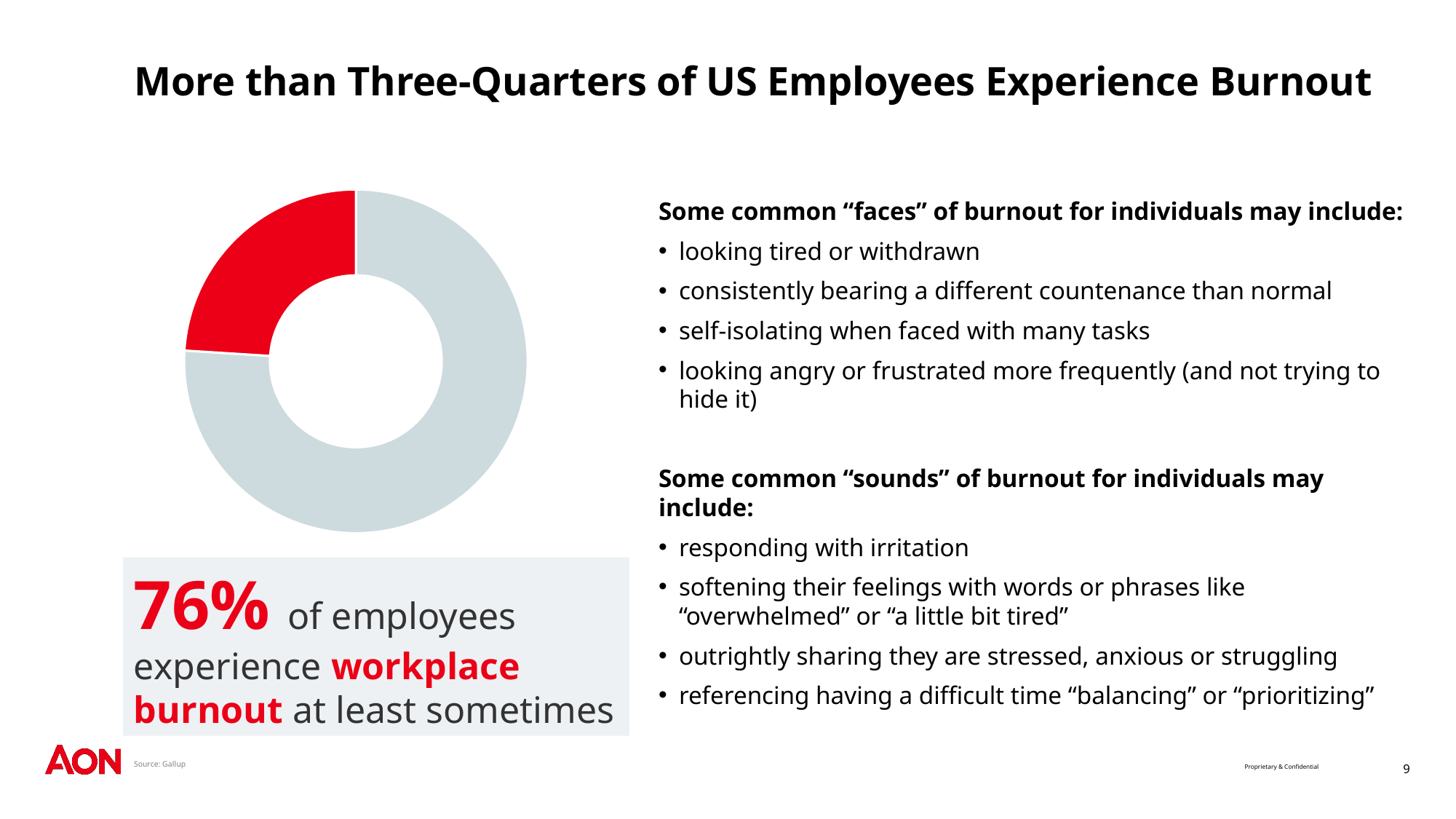
What two colours are used for the slices of the donut chart? Red and grey How many slices does the donut chart have? 2 Is the grey slice of the donut chart greater or less than half of the ring? greater According to the callout below the chart, what percentage of employees experience workplace burnout at least sometimes? 76% Does the donut chart have a legend? No What kind of chart is shown on the slide? Donut (pie) chart Which slice of the donut chart is larger, the red one or the grey one? The grey one Is the red slice of the donut chart greater or less than half of the ring? less What source is cited for the chart data at the bottom of the slide? Gallup